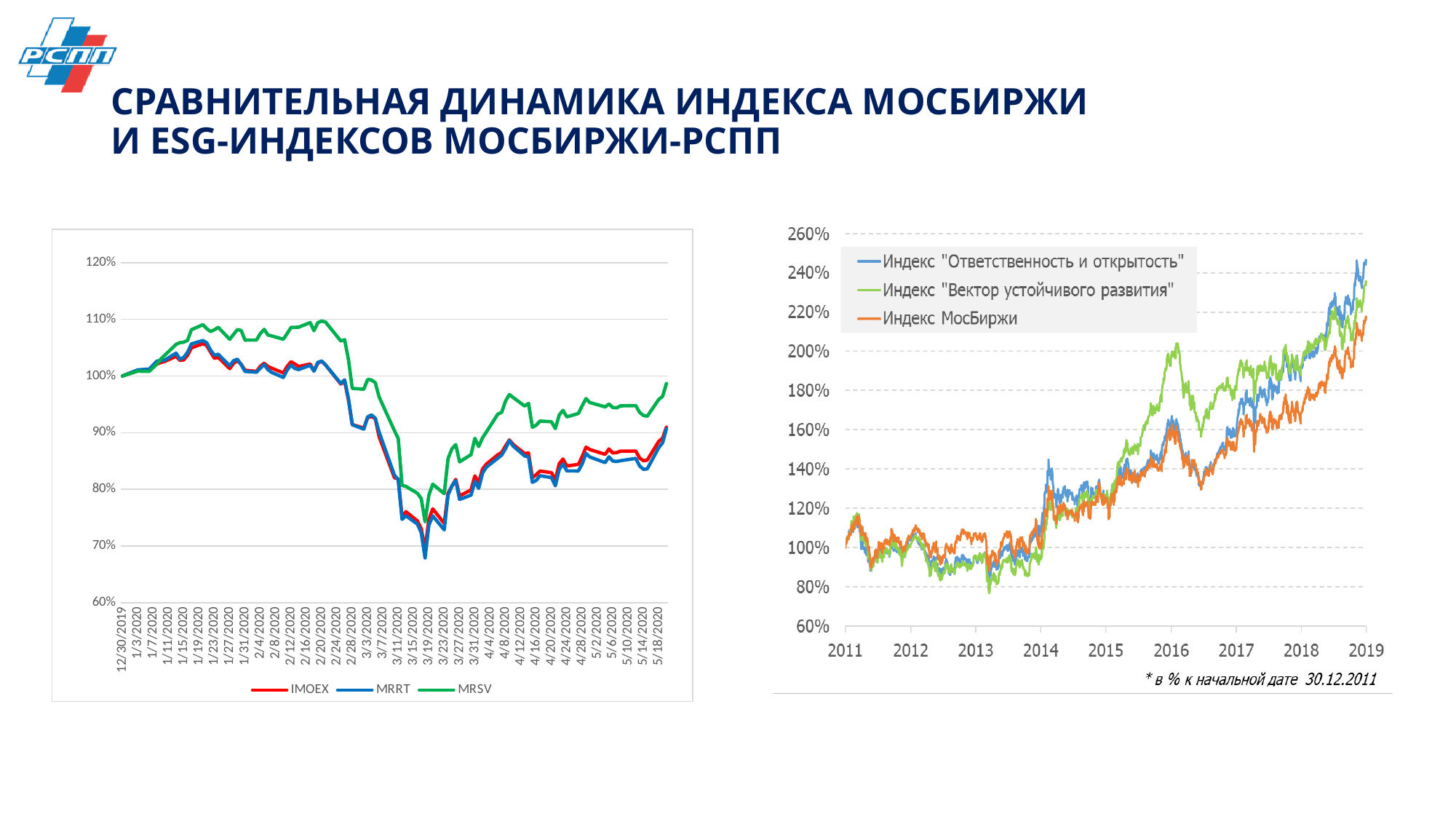
In the left chart, which series is highest at the last date, 5/18/2020? MRSV How many series does the legend of the right chart list? 3 What kind of chart is the right chart (2011–2019)? line chart In the left chart, what value do all three series start at on 12/30/2019? 100% In the left chart, is the value of MRSV on 5/18/2020 greater or less than 90%? greater In the right chart, do the series generally rise or fall from 2011 to 2019? rise How many series does the legend of the left chart list? 3 In the right chart, which series is highest at the end of the period in 2019? Индекс "Ответственность и открытость" In the right chart, which colour represents Индекс МосБиржи? orange In the right chart, is the value of Индекс МосБиржи at the end of 2018/start of 2019 greater or less than 200%? greater What kind of chart is the left chart (IMOEX, MRRT, MRSV)? line chart In the left chart, is the lowest value reached by MRRT in March 2020 greater or less than 70%? less